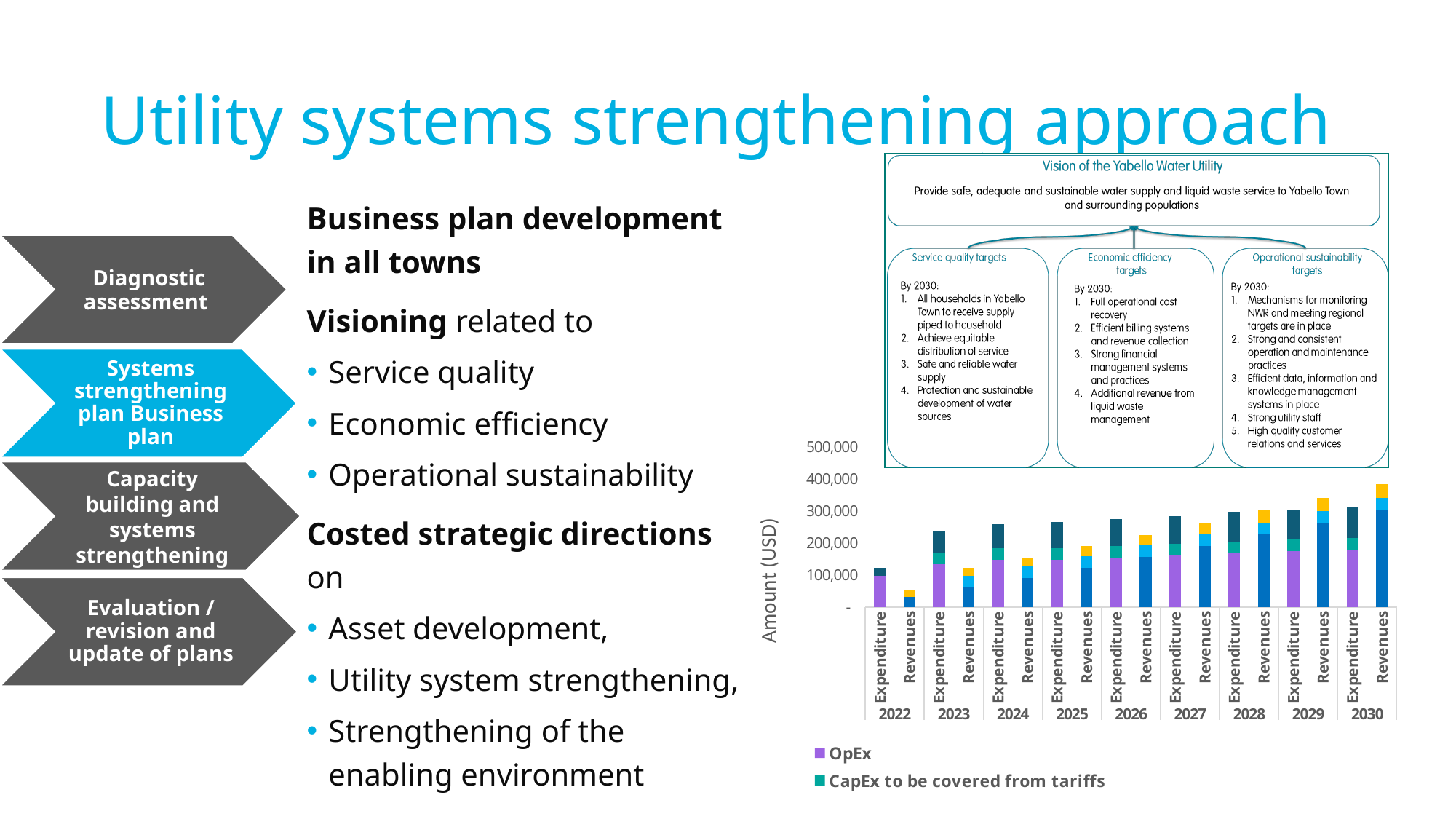
Which year has the tallest Revenues bar? 2030 Is the total Expenditure bar for 2022 greater or less than 200,000? less What is the label of the vertical axis of the chart? Amount (USD) Which year has the shortest Revenues bar? 2022 Is the total Revenues bar for 2029 greater or less than 400,000? less Is the total Revenues bar for 2022 greater or less than 100,000? less What is the first entry listed in the chart legend? OpEx What kind of chart is shown on the slide? Stacked bar chart How many years are shown on the x axis of the chart? 9 Do the Revenues bars rise or fall from 2022 to 2030? Rise